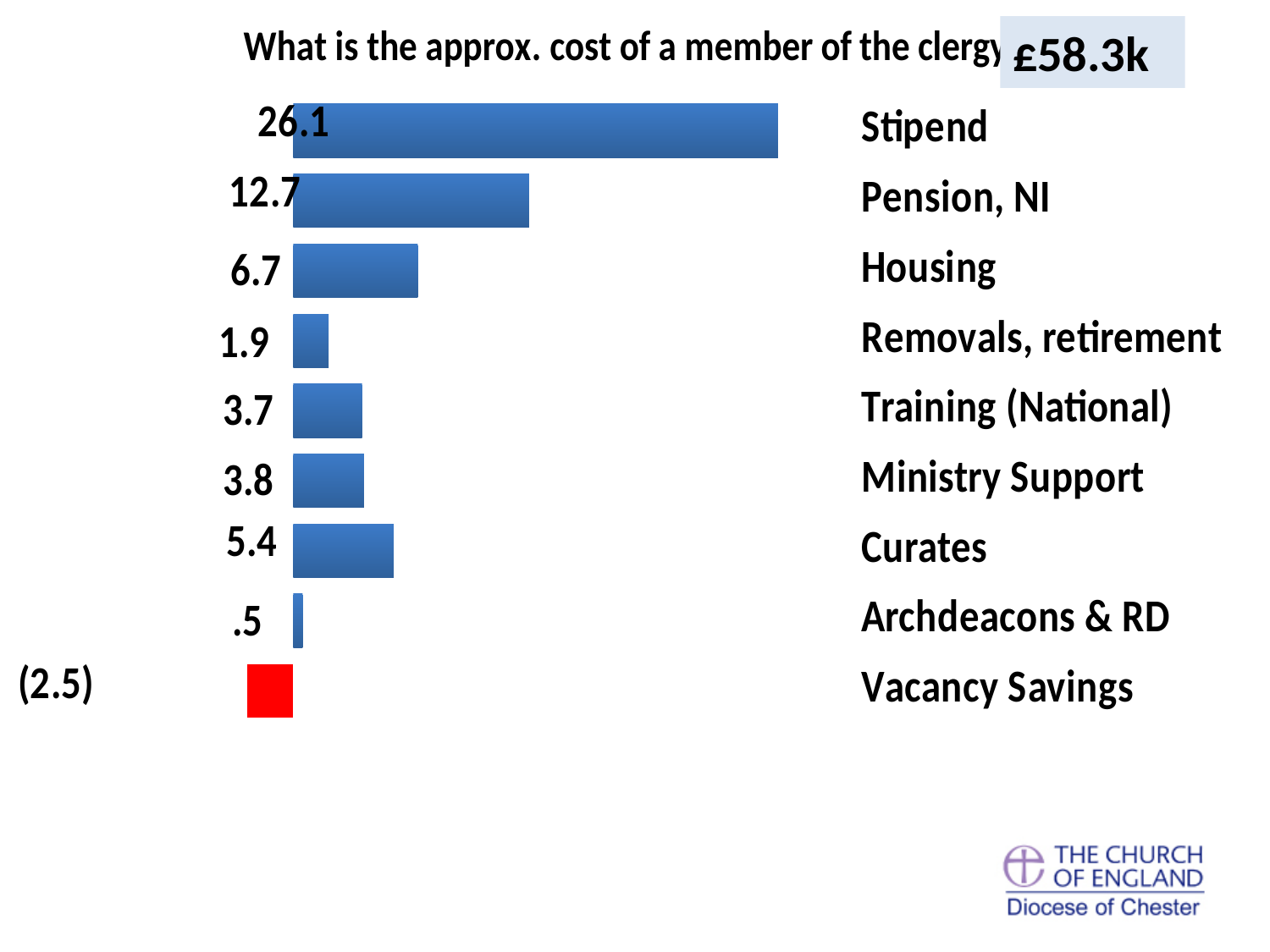
How many categories are shown in the chart? 9 What kind of chart is shown on the slide? Bar chart Which is larger, the value for Housing or the value for Curates? Housing What is the value for Pension, NI? 12.7 What is the value for Curates? 5.4 What is the value for Stipend? 26.1 Which category has the highest value? Stipend What is the value for Housing? 6.7 What value is shown for Vacancy Savings? (2.5) Which category has the shortest blue bar? Archdeacons & RD What is the difference between the values for Stipend and Pension, NI? 13.4 Which category is shown with a red bar? Vacancy Savings